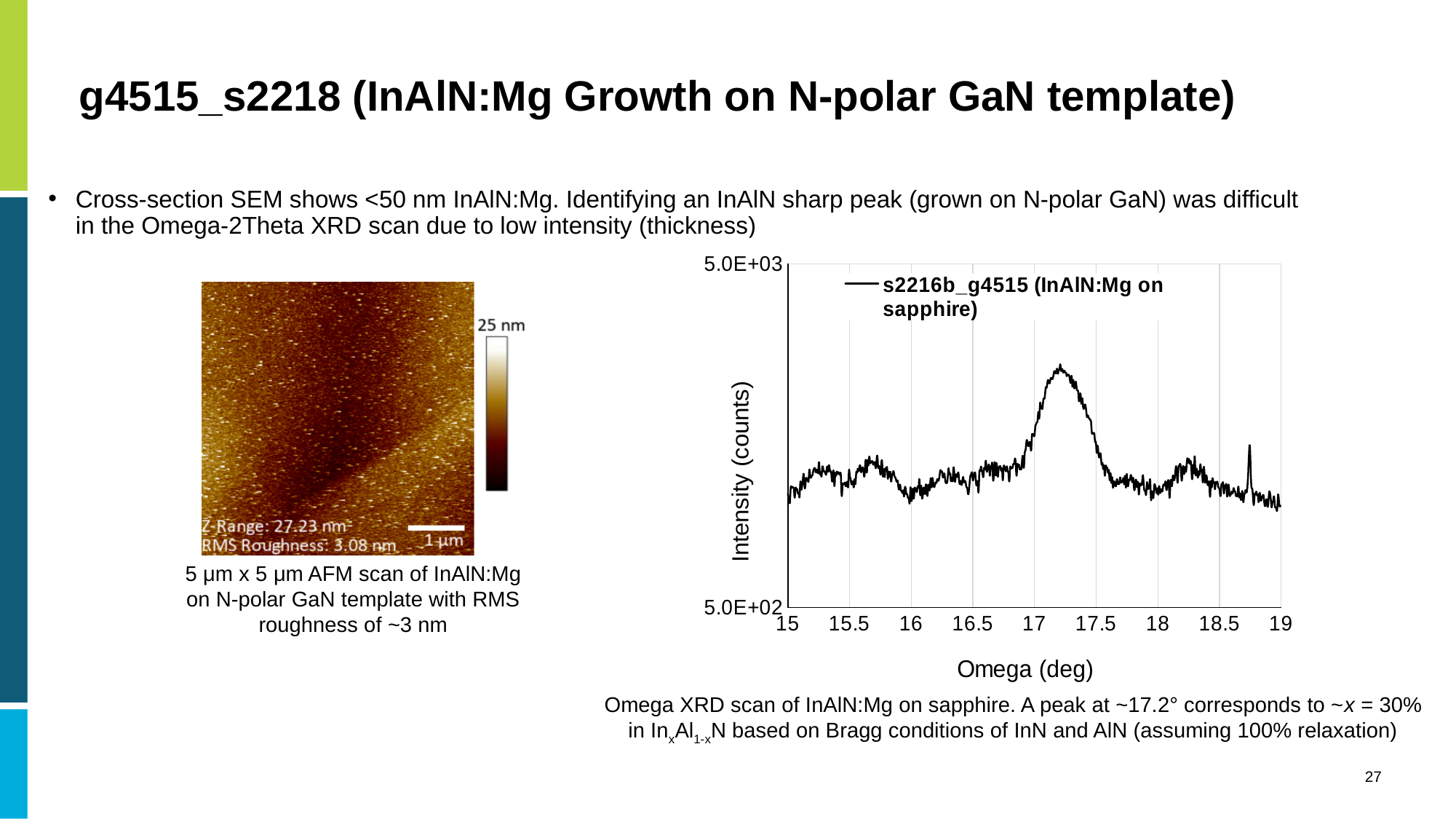
What is the lowest value labelled on the y-axis of the XRD chart? 5.0E+02 Is the intensity at Omega = 15 in the XRD chart greater or less than 5.0E+02? greater Between which two x-axis tick labels does the main peak of the XRD chart occur? 17 and 17.5 Is the peak intensity in the XRD chart greater or less than 5.0E+03? less What is the highest value labelled on the y-axis of the XRD chart? 5.0E+03 What kind of chart is shown on the right of the slide? line chart In the XRD chart, does the intensity rise or fall as Omega goes from 17 to 17.25? rise In the XRD chart, does the intensity rise or fall as Omega goes from 17.25 to 17.75? fall What is the legend entry of the series plotted in the XRD chart? s2216b_g4515 (InAlN:Mg on sapphire) How many tick labels are shown on the x-axis of the XRD chart? 9 How many series does the legend of the XRD chart list? 1 What is the x-axis label of the XRD chart? Omega (deg)